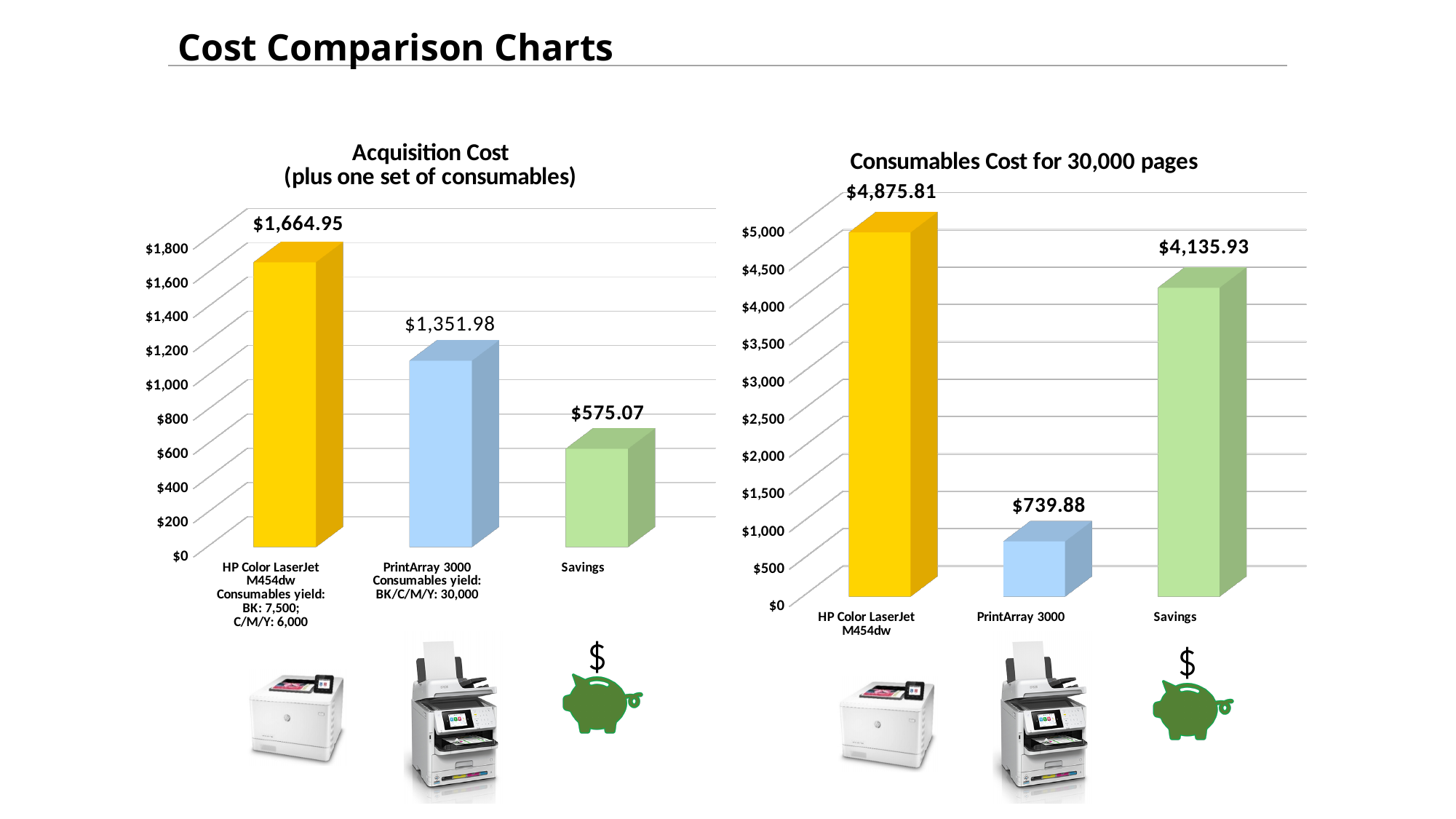
In the Acquisition Cost chart, which category has the highest value? HP Color LaserJet M454dw In the Consumables Cost for 30,000 pages chart, what is the value for Savings? $4,135.93 In the Acquisition Cost chart, what is the value for PrintArray 3000? $1,351.98 In the Acquisition Cost chart, what is the value for HP Color LaserJet M454dw? $1,664.95 What type of chart is the Acquisition Cost chart? Bar chart How many bars are plotted in the Consumables Cost for 30,000 pages chart? 3 In the Acquisition Cost chart, which is larger: the value for PrintArray 3000 or the value for Savings? PrintArray 3000 In the Consumables Cost for 30,000 pages chart, what is the difference between the HP Color LaserJet M454dw and PrintArray 3000 values? $4,135.93 In the Consumables Cost for 30,000 pages chart, which category has the lowest value? PrintArray 3000 In the Acquisition Cost chart, what is the value for Savings? $575.07 In the Consumables Cost for 30,000 pages chart, what is the value for PrintArray 3000? $739.88 In the Consumables Cost for 30,000 pages chart, what is the value for HP Color LaserJet M454dw? $4,875.81